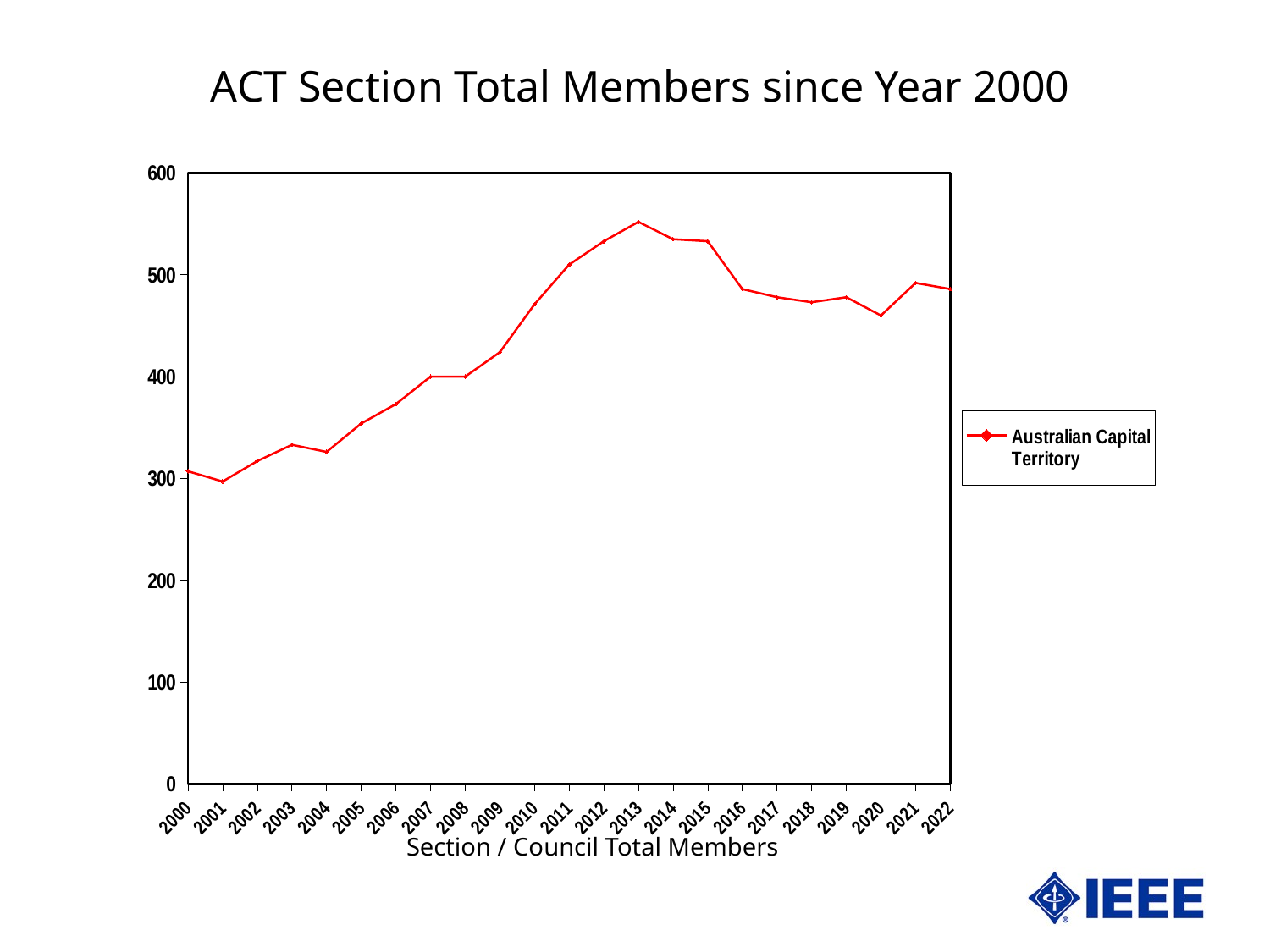
How many years are plotted along the x axis? 23 What kind of chart is shown on the slide? Line chart In which year is the number of members lowest? 2001 Is the value for 2013 greater or less than 500? greater How many series does the legend list? 1 What is the name of the series shown in the legend? Australian Capital Territory Do the values rise or fall from 2000 to 2013? Rise Is the value for 2010 greater or less than 400? greater In which year is the number of members highest? 2013 Is the value for 2020 greater or less than 500? less Which year has more members, 2000 or 2010? 2010